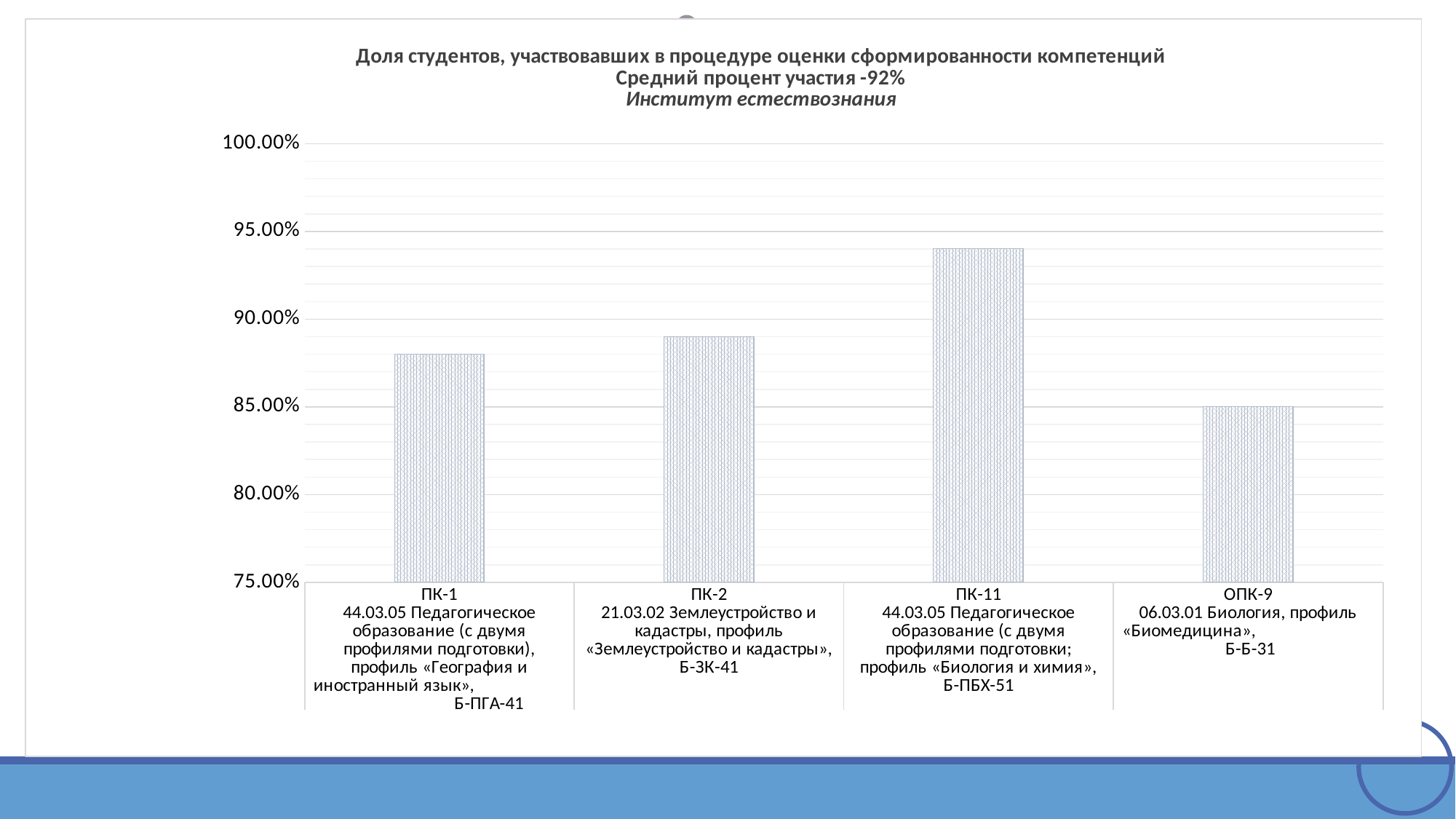
Is the value for ПК-1 greater or less than 90.00%? less What average participation percentage is stated in the chart title? 92% What kind of chart is shown on the slide? bar chart Which competency has the lowest share of students participating? ОПК-9 How many categories (competencies) are plotted on the chart? 4 Which competency has the highest share of students participating? ПК-11 Which is larger, the value for ПК-11 or the value for ПК-1? ПК-11 Is the value for ПК-11 greater or less than 90.00%? greater Which is larger, the value for ПК-2 or the value for ОПК-9? ПК-2 Is the value for ОПК-9 greater or less than 90.00%? less Which institute is named in the chart title? Институт естествознания